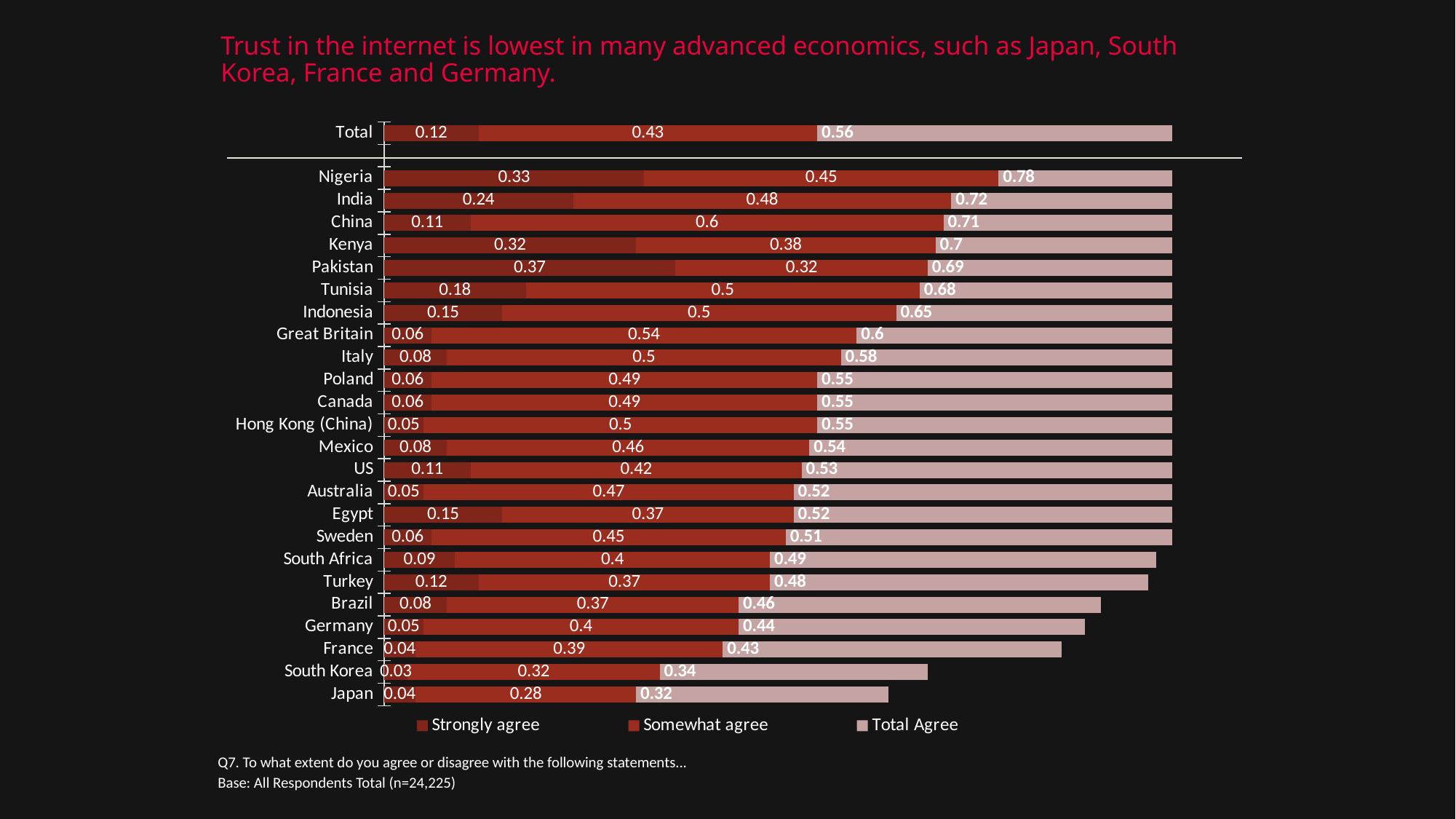
What is the Total Agree value for Japan? 0.32 Which country has the highest Strongly agree value? Pakistan What is the Strongly agree value for Nigeria? 0.33 Which country has the lowest Total Agree value? Japan How many series does the legend list? 3 How many countries (excluding the Total row) are shown in the chart? 24 What kind of chart is shown on the slide? Bar chart What is the Total Agree value for the Total row? 0.56 Which has a larger Strongly agree value, Pakistan or Kenya? Pakistan What is the Somewhat agree value for China? 0.6 Which country has the highest Total Agree value? Nigeria What is the difference between the Total Agree values for Nigeria and Japan? 0.46